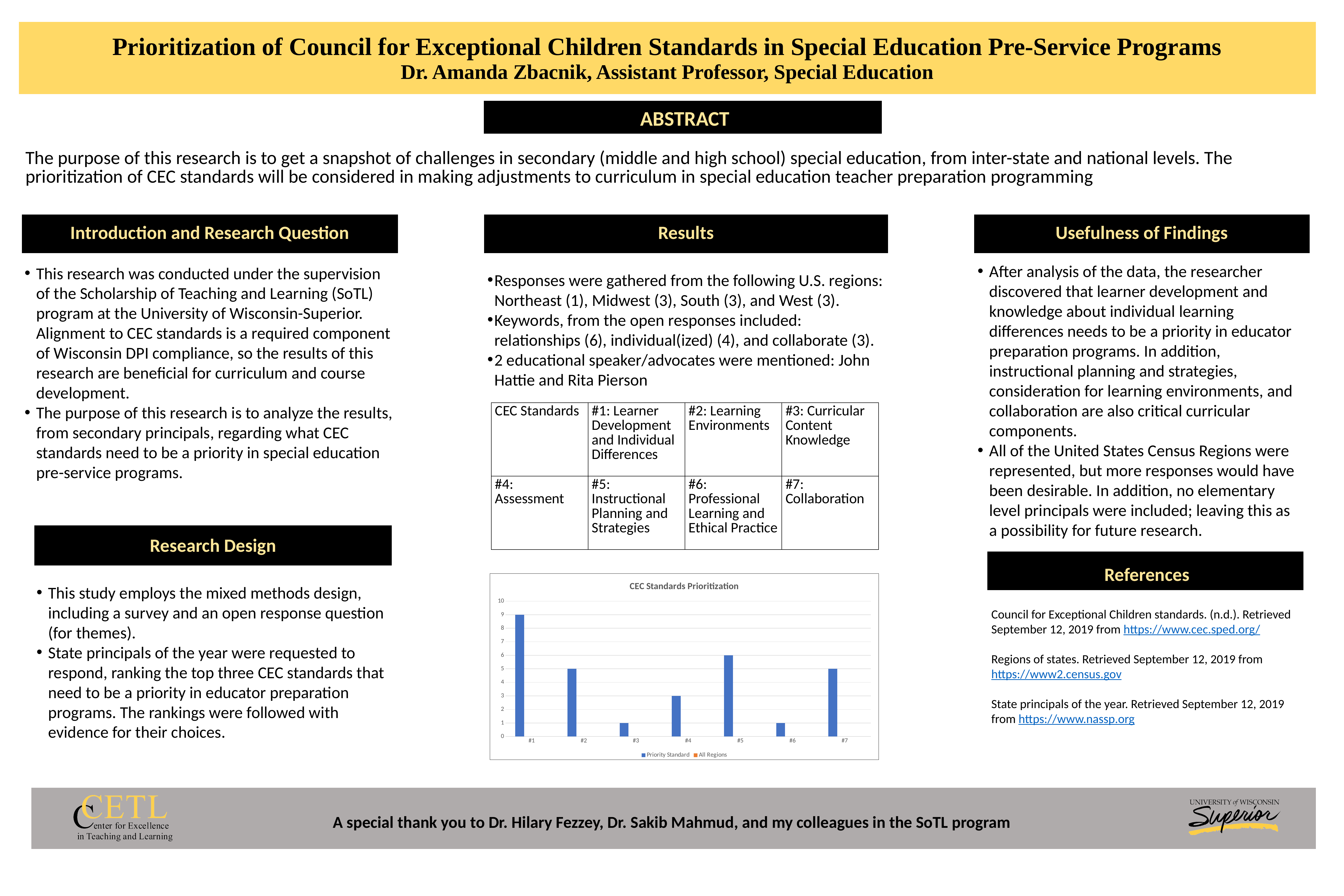
Which category has the highest bar in the CEC Standards Prioritization chart? #1 What kind of chart is the CEC Standards Prioritization chart? bar chart What is the title of the chart on the slide? CEC Standards Prioritization What is the value for #1 in the CEC Standards Prioritization chart? 9 Which is larger in the CEC Standards Prioritization chart, the value for #2 or the value for #4? #2 What is the value for #5 in the CEC Standards Prioritization chart? 6 Is the value for #7 in the CEC Standards Prioritization chart greater or less than 4? greater How many categories are shown on the x axis of the CEC Standards Prioritization chart? 7 What are the two legend entries in the CEC Standards Prioritization chart? Priority Standard and All Regions What is the value for #4 in the CEC Standards Prioritization chart? 3 How many series does the legend of the CEC Standards Prioritization chart list? 2 What is the difference between the values for #1 and #5 in the CEC Standards Prioritization chart? 3